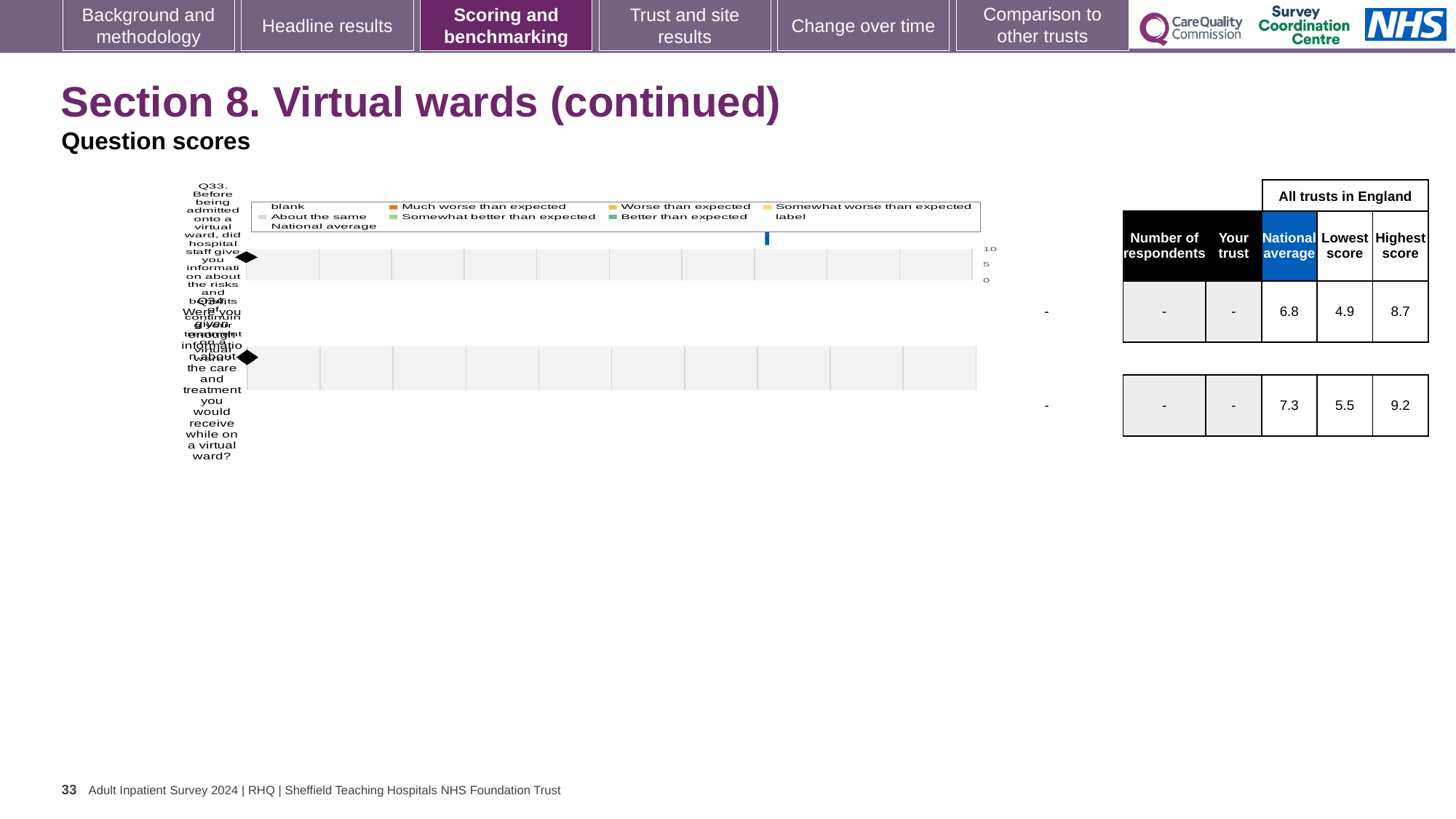
In the table to the right of the chart, what value is shown for 'Your trust' for Q33? - How many question categories are listed on the chart's vertical axis? 2 In the table to the right of the chart, which question has the higher national average, Q33 or Q34? Q34 What is the highest value shown on the chart's horizontal axis? 10 In the table to the right of the chart, what is the national average for Q34? 7.3 In the table to the right of the chart, what is the lowest score for Q33? 4.9 In the table to the right of the chart, what is the national average for Q33? 6.8 In the table to the right of the chart, what is the highest score for Q34? 9.2 What kind of chart is shown on the slide? bar chart In the table to the right of the chart, what is the difference between the highest and lowest score for Q34? 3.7 In the table to the right of the chart, what is the difference between the highest and lowest score for Q33? 3.8 Which legend entry is shown with an orange marker? Much worse than expected